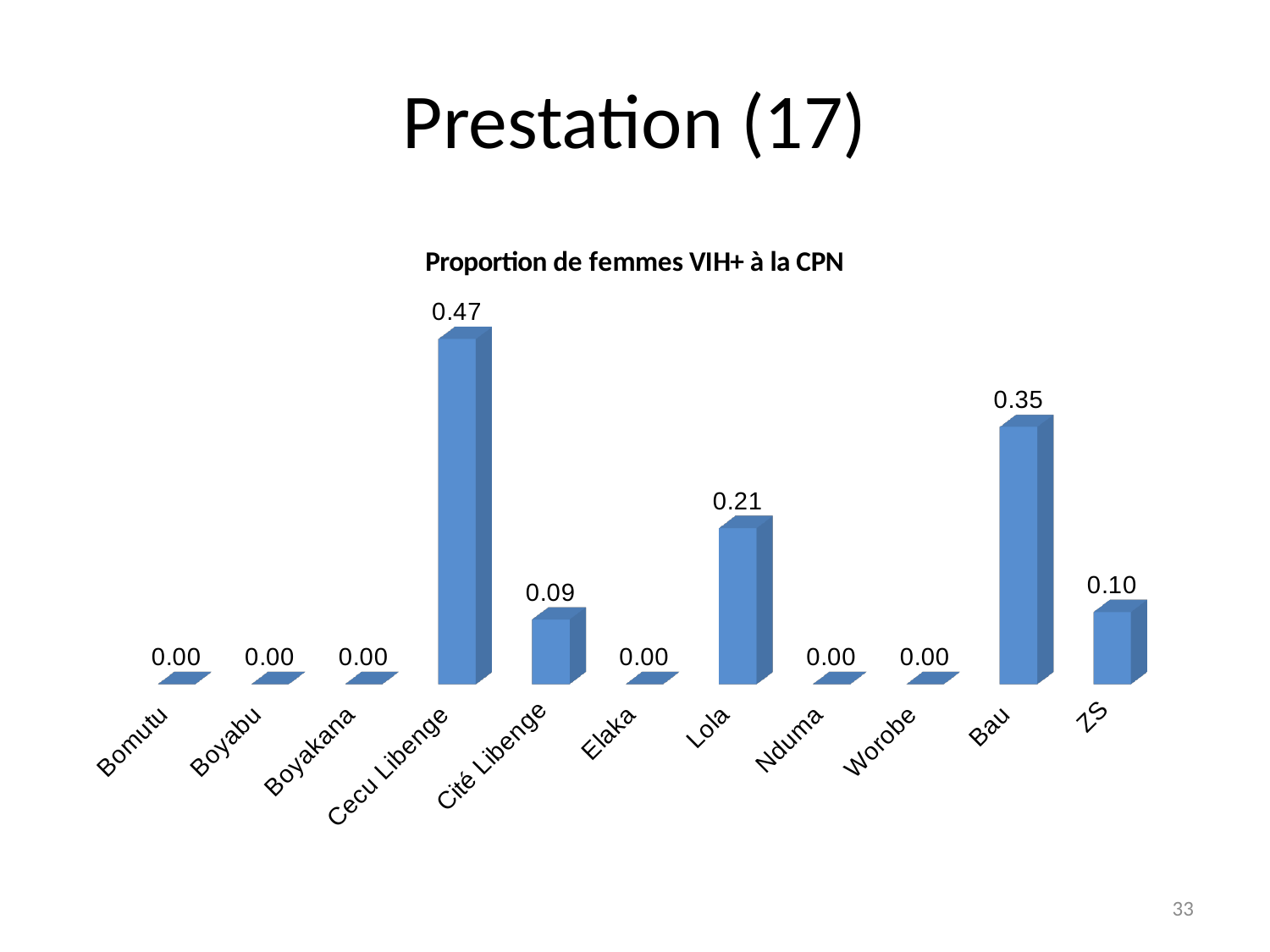
What is the difference between the values for Lola and Cité Libenge? 0.12 What is the value for Cecu Libenge? 0.47 How many categories are shown on the x axis? 11 What is the value for Cité Libenge? 0.09 What is the title of the chart? Proportion de femmes VIH+ à la CPN What is the difference between the values for Cecu Libenge and Bau? 0.12 What is the value for ZS? 0.10 How many categories have a value of 0.00? 6 Which category has the highest value? Cecu Libenge Which is larger, the value for Bau or the value for Lola? Bau What is the value for Lola? 0.21 What is the value for Bau? 0.35